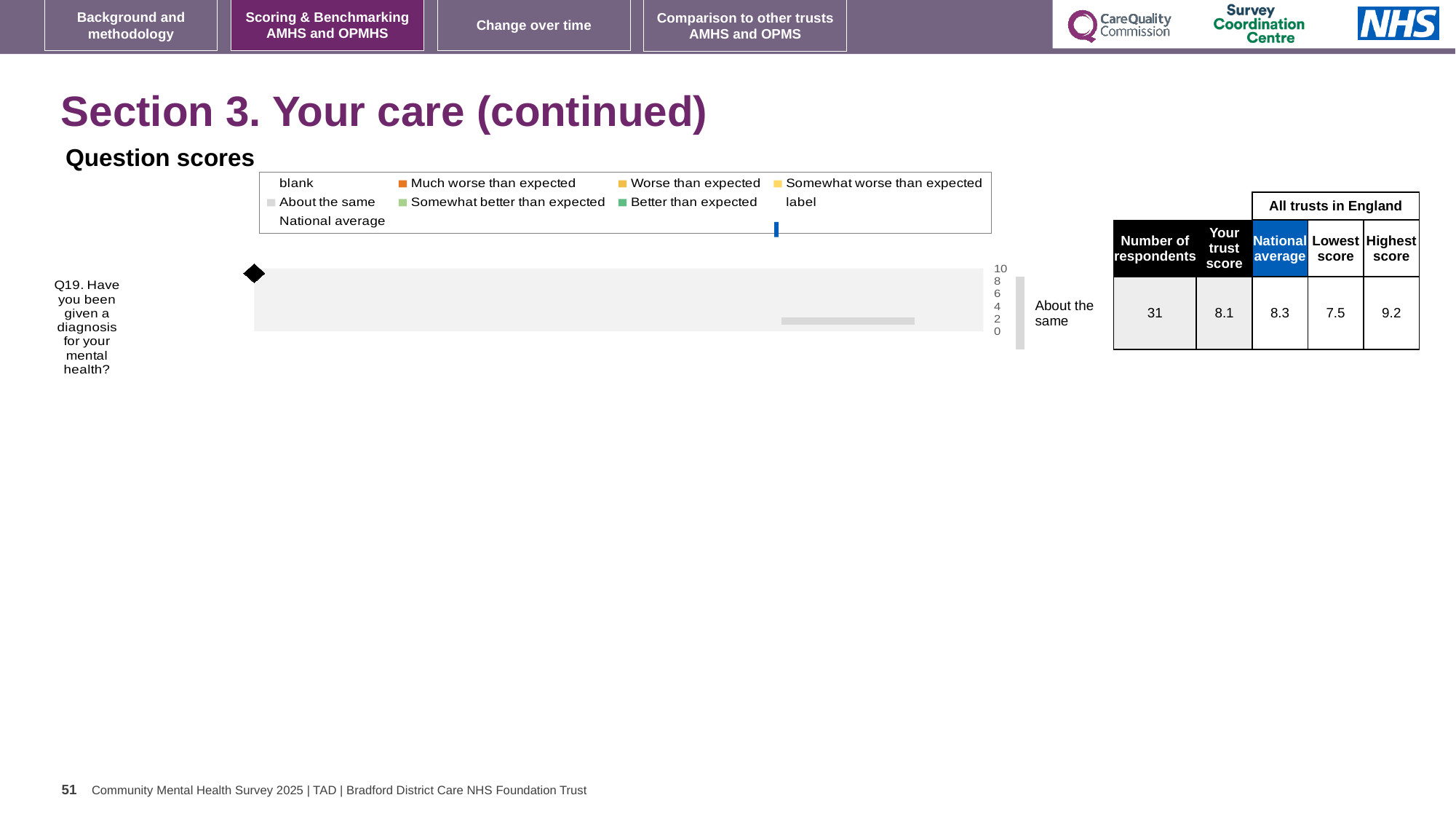
Which is larger for Q19, the trust score or the national average? National average What is the trust score for Q19 (Have you been given a diagnosis for your mental health?)? 8.1 What is the lowest score among all trusts in England for Q19? 7.5 How many questions are plotted in the Question scores chart? 1 What is the title of the chart on the slide? Question scores What is the national average score for Q19? 8.3 How many respondents answered Q19? 31 What is the difference between the highest score and the lowest score for Q19? 1.7 What is the highest score among all trusts in England for Q19? 9.2 What kind of chart is used to show the Q19 question score? bar chart What benchmark category is shown next to the Q19 bar? About the same By how much does the national average exceed the trust score for Q19? 0.2